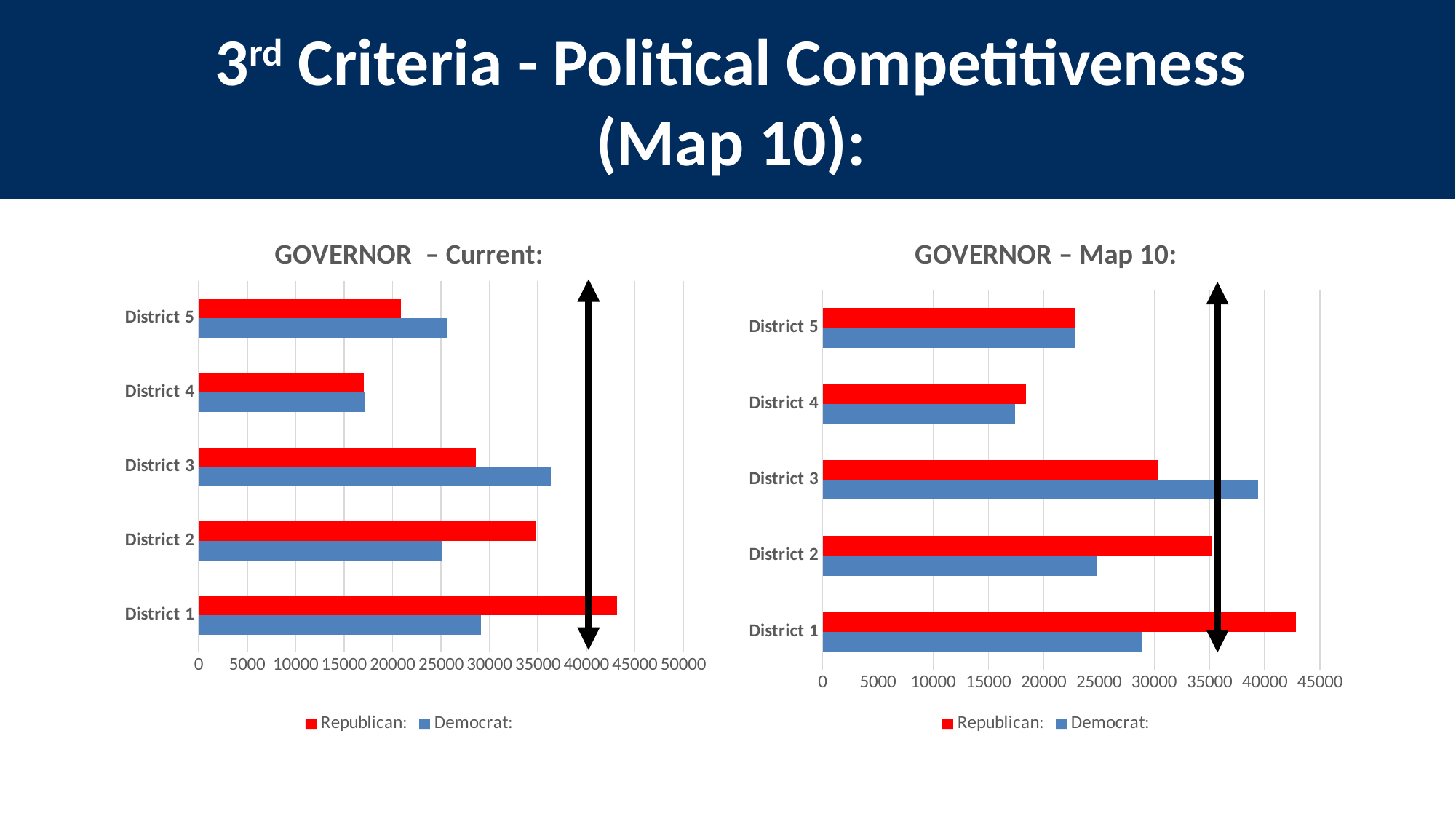
In the GOVERNOR – Map 10 chart, how many series does the legend list? 2 In the GOVERNOR – Map 10 chart, for District 2, which is larger: the Republican or the Democrat value? Republican In the GOVERNOR – Current chart, is the Democrat value for District 2 greater or less than 30000? less In the GOVERNOR – Current chart, how many districts are plotted? 5 In the GOVERNOR – Current chart, for District 3, which is larger: the Republican or the Democrat value? Democrat In the GOVERNOR – Current chart, which district has the lowest Republican value? District 4 In the GOVERNOR – Current chart, which district has the highest Democrat value? District 3 In the GOVERNOR – Current chart, is the Republican value for District 1 greater or less than 40000? greater In the GOVERNOR – Map 10 chart, is the Republican value for District 2 greater or less than 30000? greater In the GOVERNOR – Current chart, which district has the highest Republican value? District 1 In the GOVERNOR – Current chart, what kind of chart is shown? bar chart In the GOVERNOR – Map 10 chart, which district has the highest Democrat value? District 3